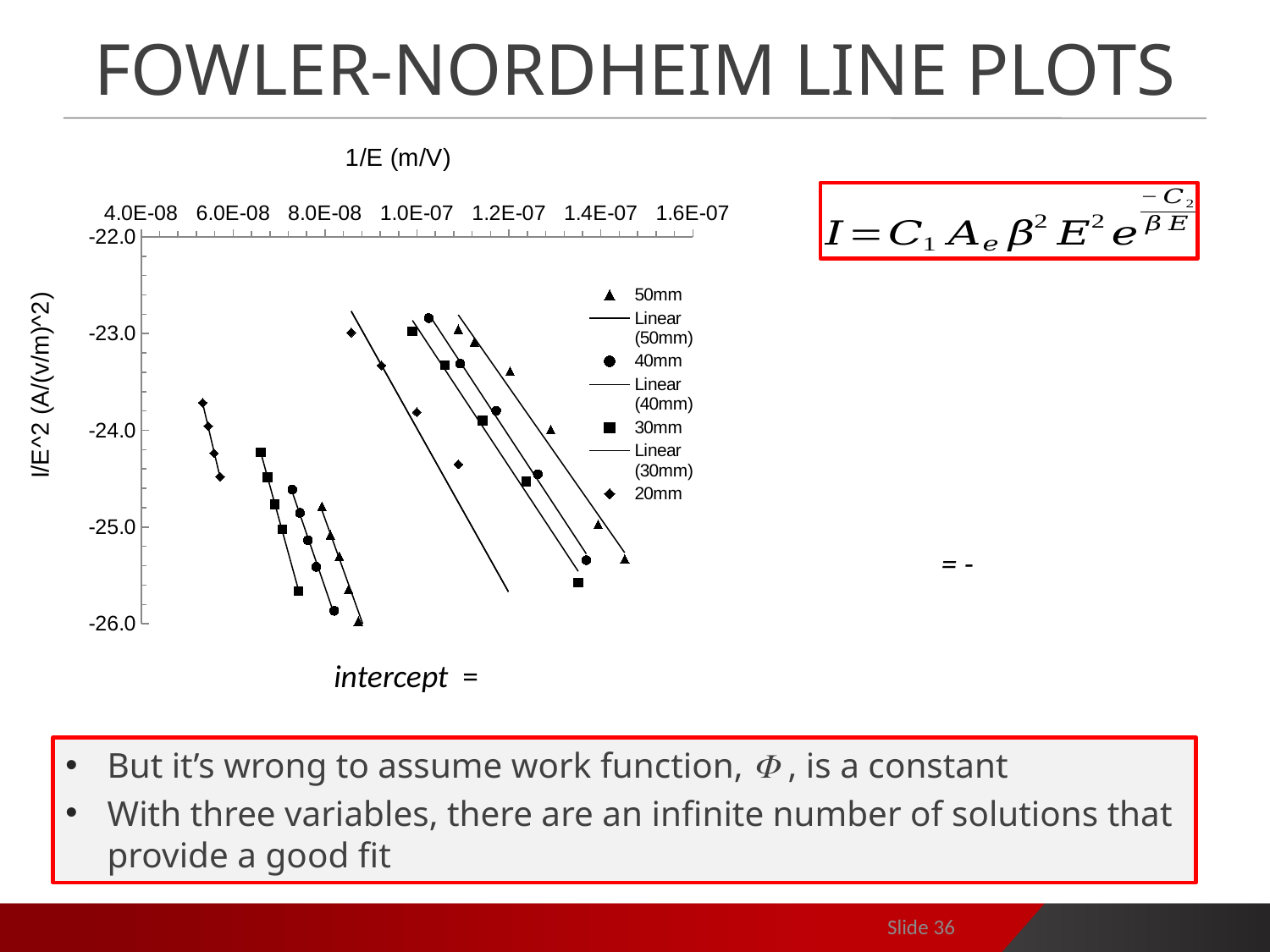
What is the title of the y axis of the chart? I/E^2 (A/(v/m)^2) Do the plotted values rise or fall as 1/E increases along the x axis? fall How many entries does the chart legend list? 7 Is the lowest 50mm point on the chart greater or less than -25.0? less Which series is plotted with diamond markers? 20mm Is the leftmost 20mm point on the chart greater or less than -24.0? greater Is the highest 40mm point on the chart greater or less than -23.0? greater What is the title of the x axis of the chart? 1/E (m/V) What kind of chart is shown on the slide? scatter plot How many data series (excluding the linear fit lines) are plotted on the chart? 4